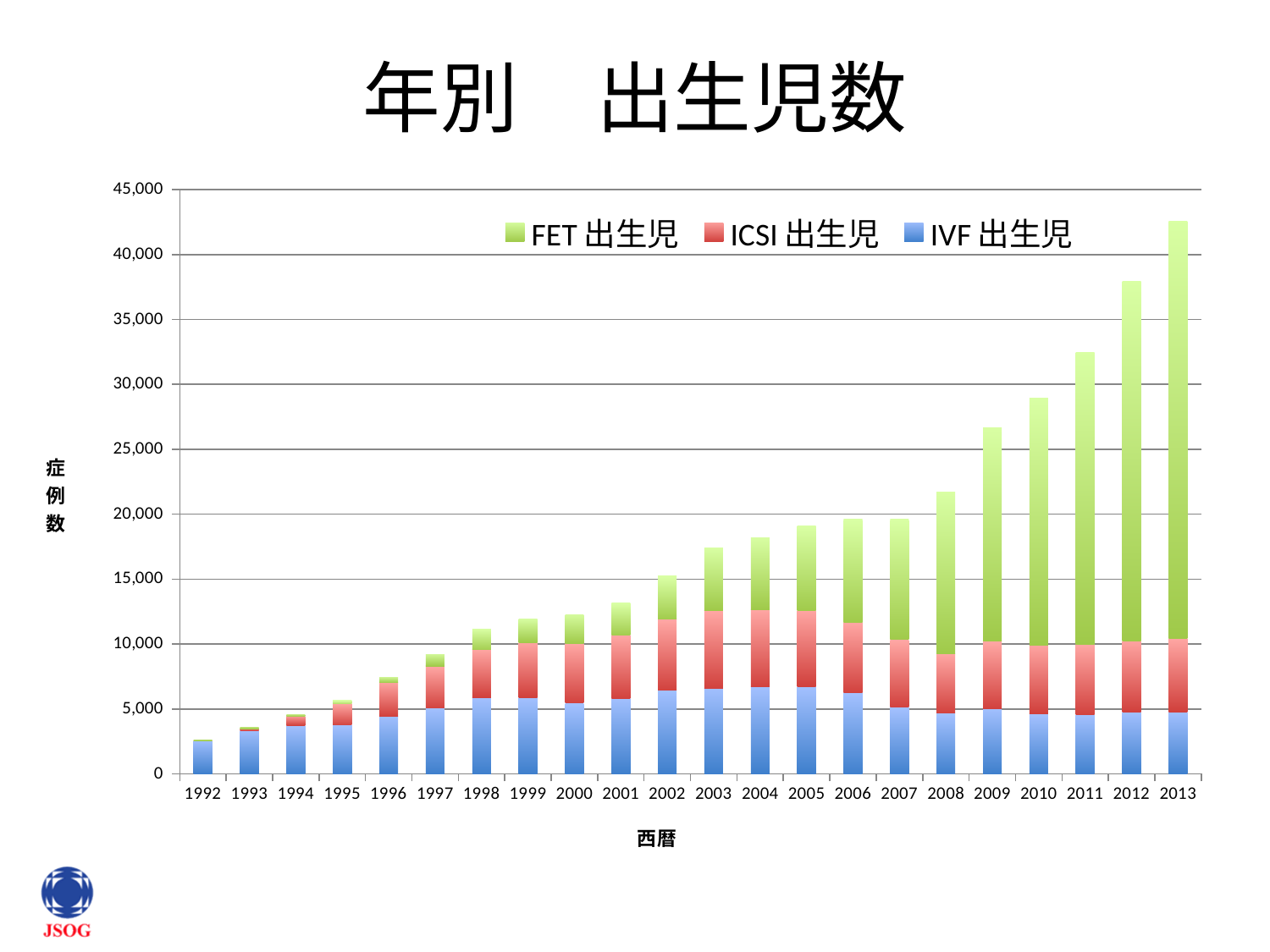
Is the total value for 2013 greater or less than 40,000? greater Which year has the larger total, 2008 or 2009? 2009 How many series does the legend list? 3 Which series is shown in green in the legend? FET 出生児 Which year has the lowest total number of births? 1992 Is the total value for 2012 greater or less than 35,000? greater How many years are shown along the x axis? 22 Is the total value for 2001 greater or less than 15,000? less What kind of chart is shown on the slide? stacked bar chart Do the total bar heights generally rise or fall from 1992 to 2013? rise Which year has the highest total number of births? 2013 What is the title of the chart? 年別 出生児数